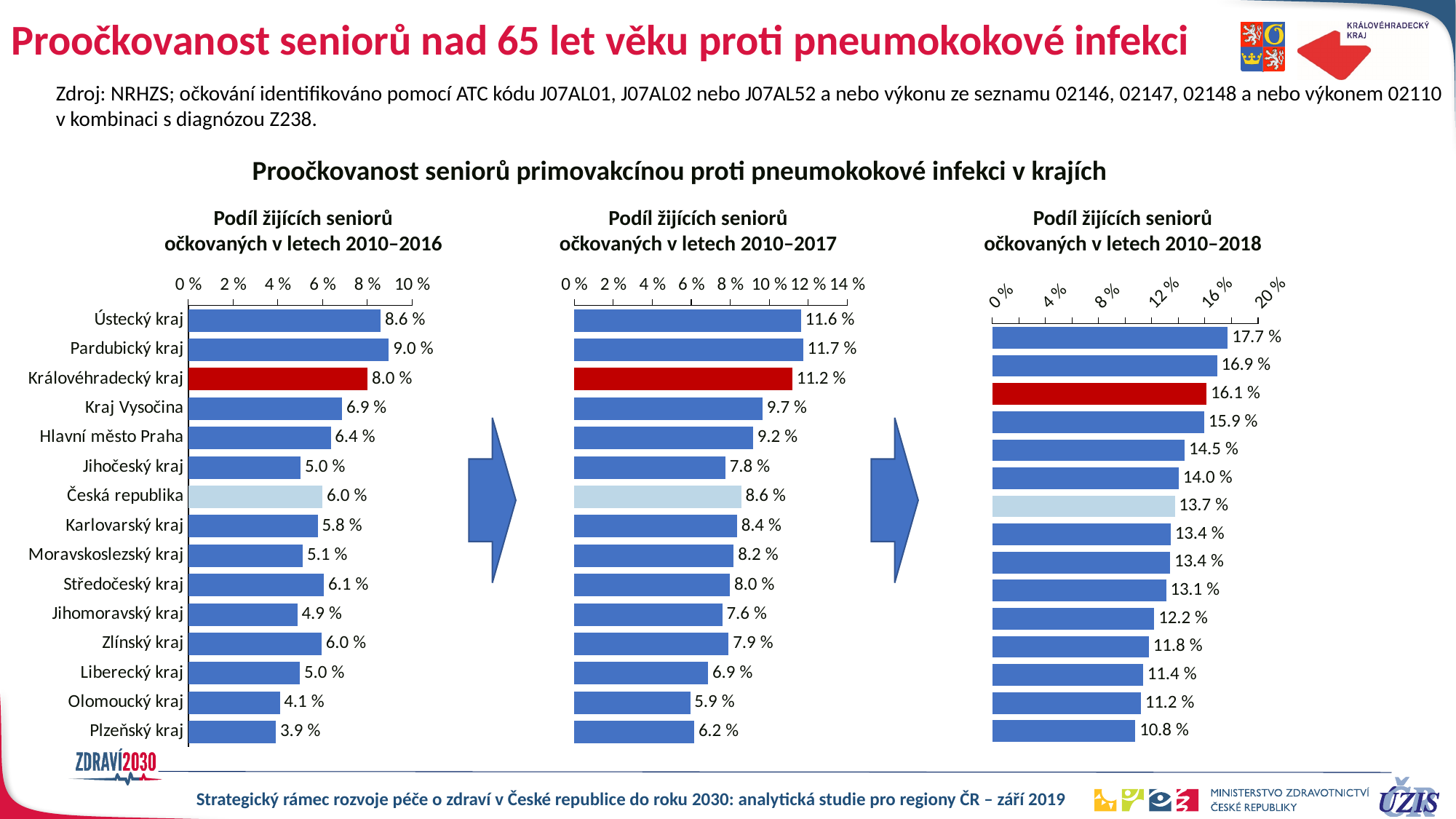
In the chart 'Podíl žijících seniorů očkovaných v letech 2010–2017', what is the value for Česká republika? 8.6 % How many bars does the chart 'Podíl žijících seniorů očkovaných v letech 2010–2016' show? 15 In the chart 'Podíl žijících seniorů očkovaných v letech 2010–2018', what is the difference between Ústecký kraj and Plzeňský kraj? 6.9 % In the chart 'Podíl žijících seniorů očkovaných v letech 2010–2016', what is the value for Královéhradecký kraj? 8.0 % In the chart 'Podíl žijících seniorů očkovaných v letech 2010–2017', what is the difference between Pardubický kraj and Královéhradecký kraj? 0.5 % In the chart 'Podíl žijících seniorů očkovaných v letech 2010–2016', which region has the lowest value? Plzeňský kraj What type of chart is 'Podíl žijících seniorů očkovaných v letech 2010–2018'? Bar chart In the chart 'Podíl žijících seniorů očkovaných v letech 2010–2016', which region has the highest value? Pardubický kraj In the chart 'Podíl žijících seniorů očkovaných v letech 2010–2017', which region has the lowest value? Olomoucký kraj In the chart 'Podíl žijících seniorů očkovaných v letech 2010–2018', what is the value for Ústecký kraj? 17.7 % In the chart 'Podíl žijících seniorů očkovaných v letech 2010–2016', which is larger, Kraj Vysočina or Hlavní město Praha? Kraj Vysočina In the chart 'Podíl žijících seniorů očkovaných v letech 2010–2018', what is the value for Královéhradecký kraj (the red bar)? 16.1 %